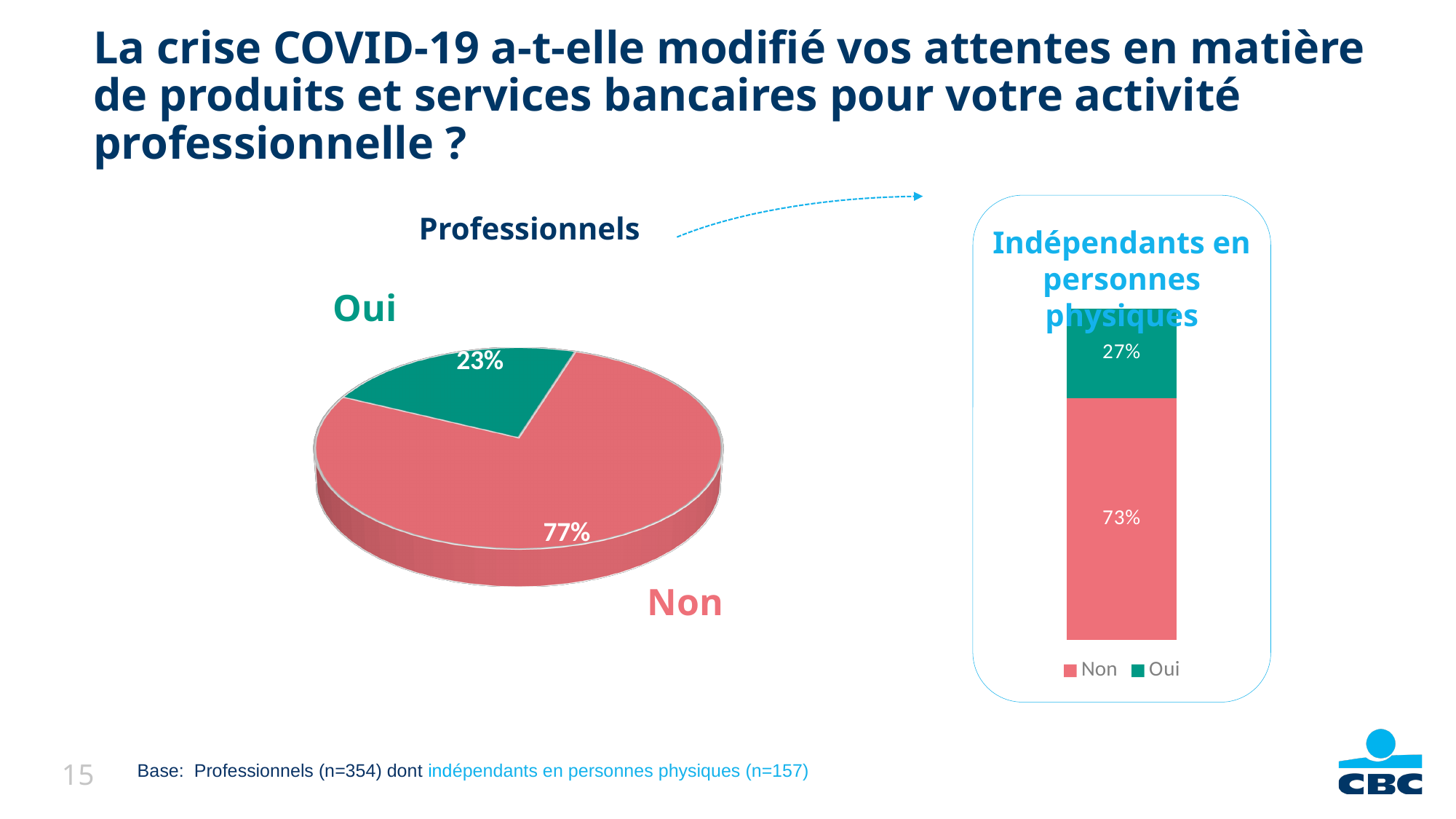
What kind of chart is the 'Indépendants en personnes physiques' chart? Stacked bar chart In the 'Indépendants en personnes physiques' chart, what colour represents 'Non'? Red/pink In the 'Professionnels' pie chart, which answer has the largest share? Non How many slices does the 'Professionnels' pie chart have? 2 What kind of chart is the 'Professionnels' chart? Pie chart In the 'Professionnels' pie chart, what is the difference in percentage points between 'Non' and 'Oui'? 54 In the 'Professionnels' pie chart, what percentage answered 'Non'? 77% Which is larger: the 'Oui' share for 'Professionnels' or the 'Oui' share for 'Indépendants en personnes physiques'? Indépendants en personnes physiques In the 'Professionnels' pie chart, what percentage answered 'Oui'? 23% In the 'Indépendants en personnes physiques' chart, what percentage answered 'Oui'? 27% In the 'Indépendants en personnes physiques' chart, what percentage answered 'Non'? 73% How many series does the legend of the 'Indépendants en personnes physiques' chart list? 2